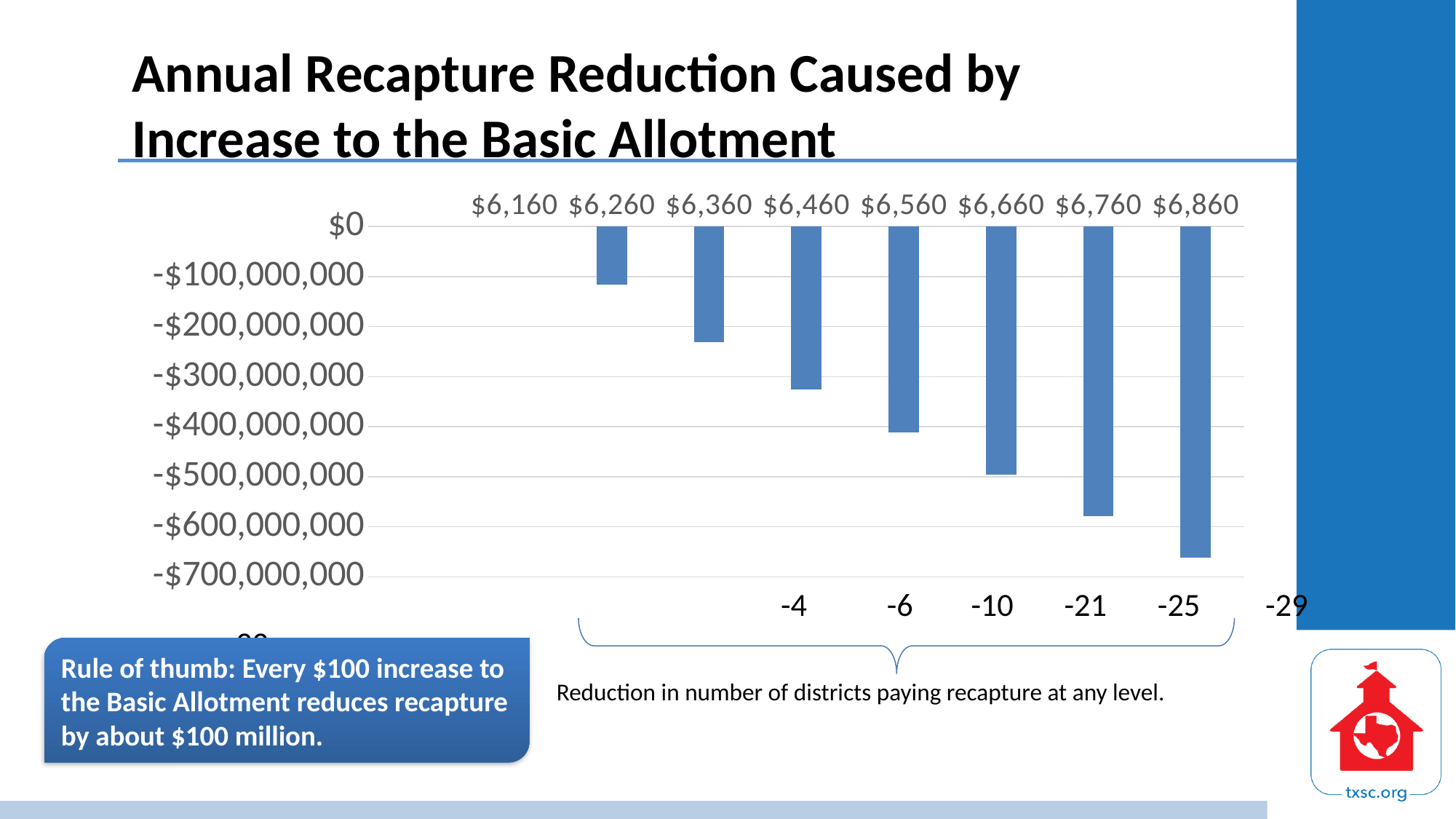
Is the value for $6,360 greater or less than -$200,000,000? less Is the value for $6,760 greater or less than -$600,000,000? greater Which basic allotment category shows the largest recapture reduction (the lowest value) in the chart? $6,860 Which has the larger recapture reduction (more negative value), $6,560 or $6,760? $6,760 Which basic allotment category has the highest value (smallest reduction) in the chart? $6,160 How many basic allotment categories are shown along the x axis of the chart? 8 Is the value for $6,460 greater or less than -$300,000,000? less What kind of chart is shown on the slide? bar chart What is the lowest value labelled on the chart's vertical axis? -$700,000,000 What is the title of the slide containing the chart? Annual Recapture Reduction Caused by Increase to the Basic Allotment Do the values in the chart rise or fall as the basic allotment increases along the x axis? fall